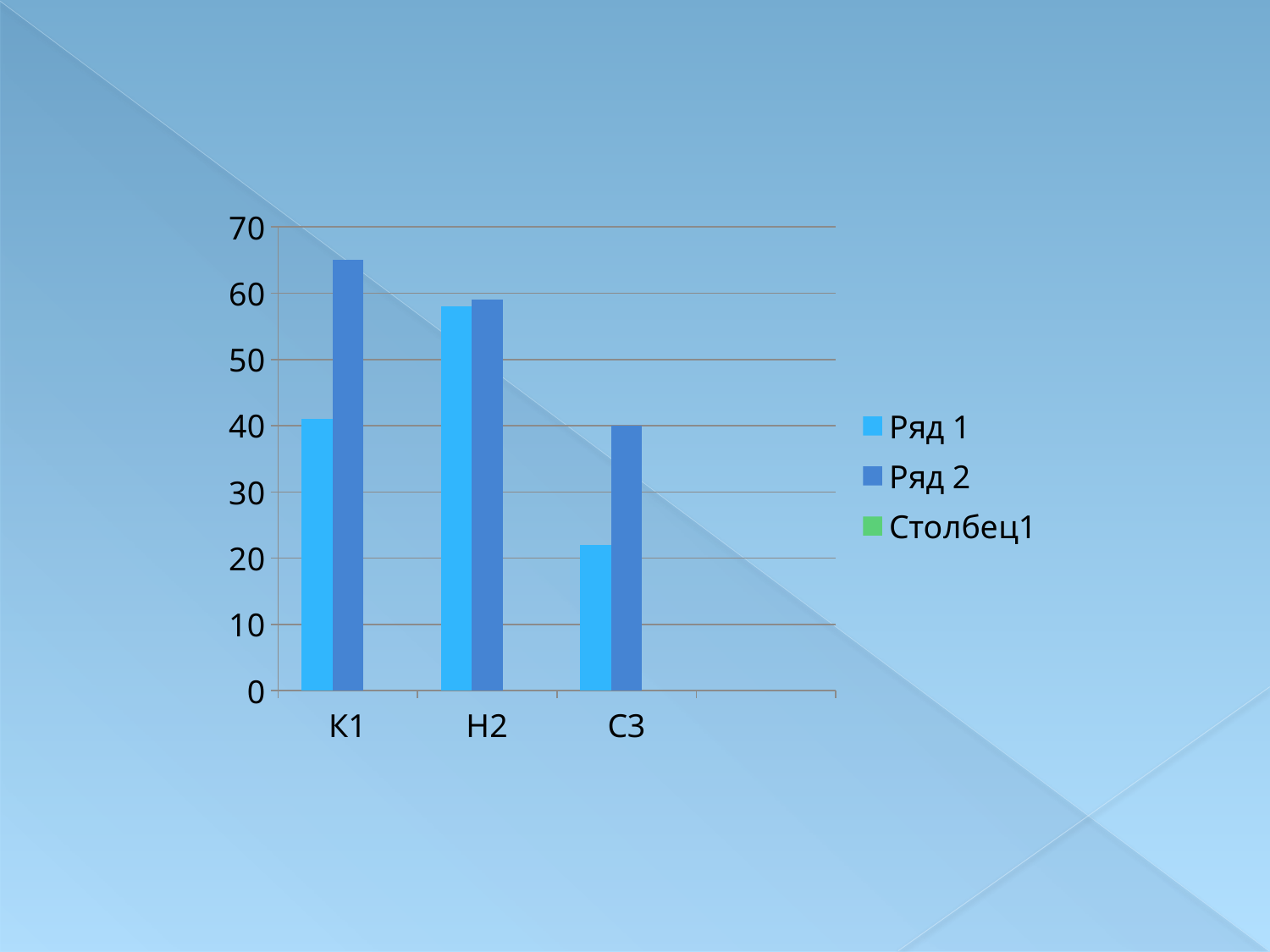
How many series does the chart's legend list? 3 Is the value for Ряд 2 at К1 greater or less than 60? greater How many categories are shown on the x axis of the chart? 3 What kind of chart is shown on the slide? bar chart Which category has the highest value for Ряд 2? К1 Is the value for Ряд 1 at К1 greater or less than 50? less Which category has the highest value for Ряд 1? Н2 At К1, which series has the larger value, Ряд 1 or Ряд 2? Ряд 2 Is the value for Ряд 1 at С3 greater or less than 30? less Do the values for Ряд 2 rise or fall from К1 to С3? fall Which category has the lowest value for Ряд 2? С3 Which category has the lowest value for Ряд 1? С3